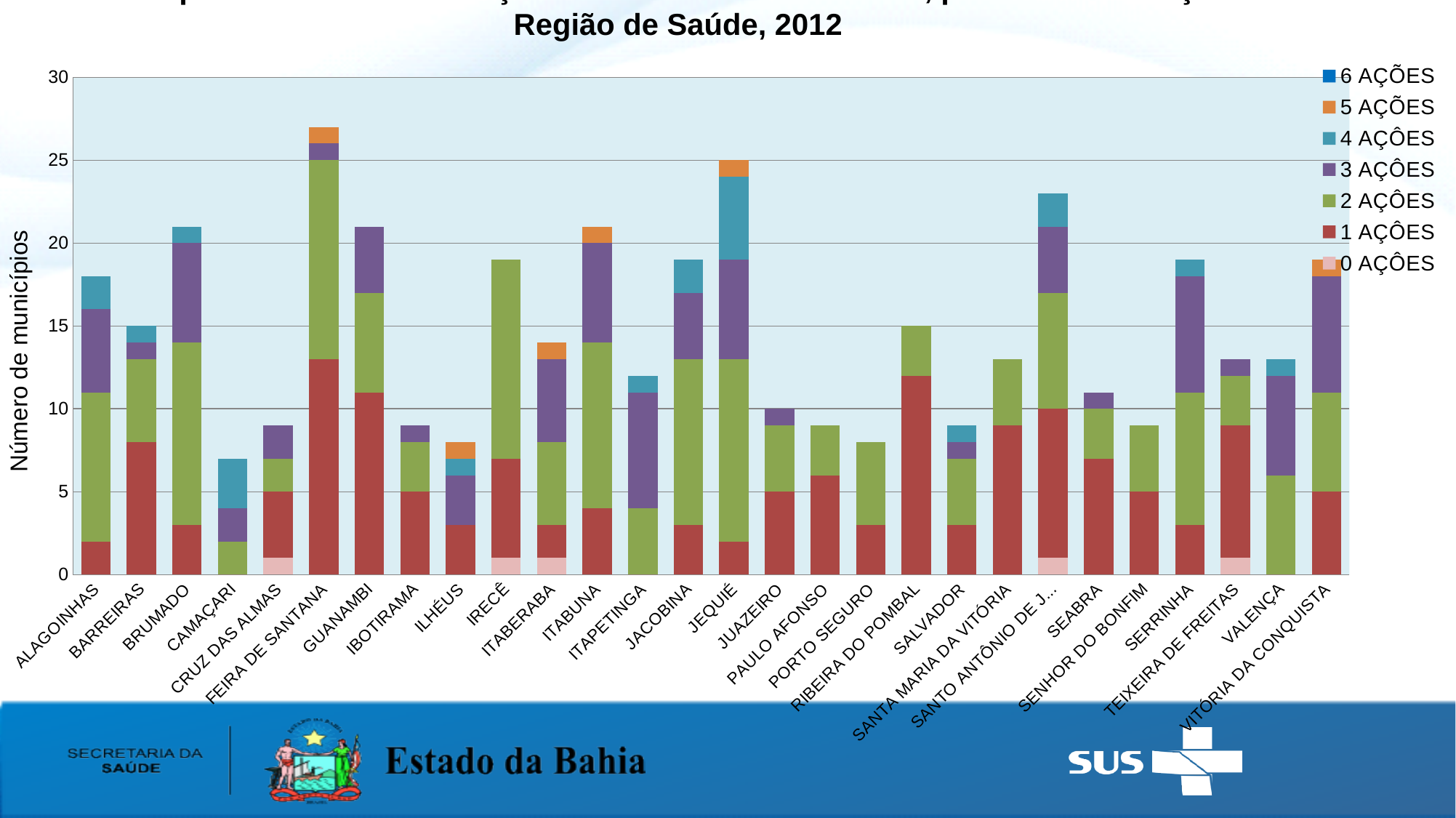
What is the title of the vertical axis? Número de municípios Which has the taller stacked bar, FEIRA DE SANTANA or JEQUIÉ? FEIRA DE SANTANA How many series does the legend list? 7 Is the total for FEIRA DE SANTANA greater or less than 25? greater Which has the taller stacked bar, BRUMADO or ALAGOINHAS? BRUMADO How many health regions (categories) are shown on the x axis? 28 Is the total for ILHÉUS greater or less than 10? less Is the total for SANTO ANTÔNIO DE J... greater or less than 20? greater What kind of chart is shown on the slide? Stacked bar chart Which health region has the tallest stacked bar? FEIRA DE SANTANA